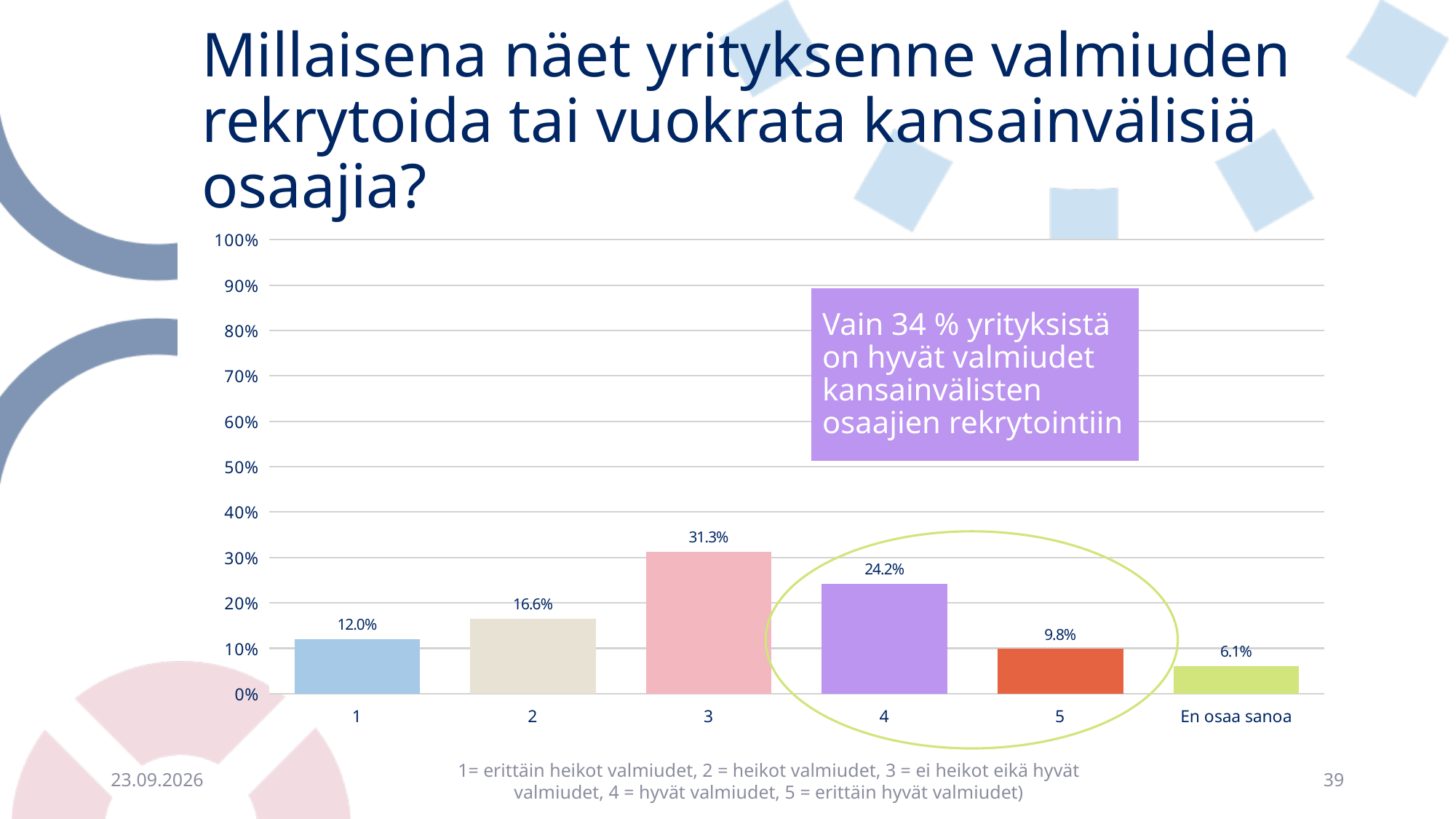
Is the value for category 3 greater or less than 30%? greater Which category has the highest value? 3 How many categories are shown on the x axis? 6 What kind of chart is shown on the slide? Bar chart Which category has the lowest value? En osaa sanoa What is the value for category 5? 9.8% Which is larger, the value for category 4 or the value for category 2? 4 What is the value for category 1? 12.0% What is the value for category 3? 31.3% What is the value for "En osaa sanoa"? 6.1% What is the difference between the values for category 3 and category 4? 7.1% What is the difference between the values for category 2 and category 1? 4.6%